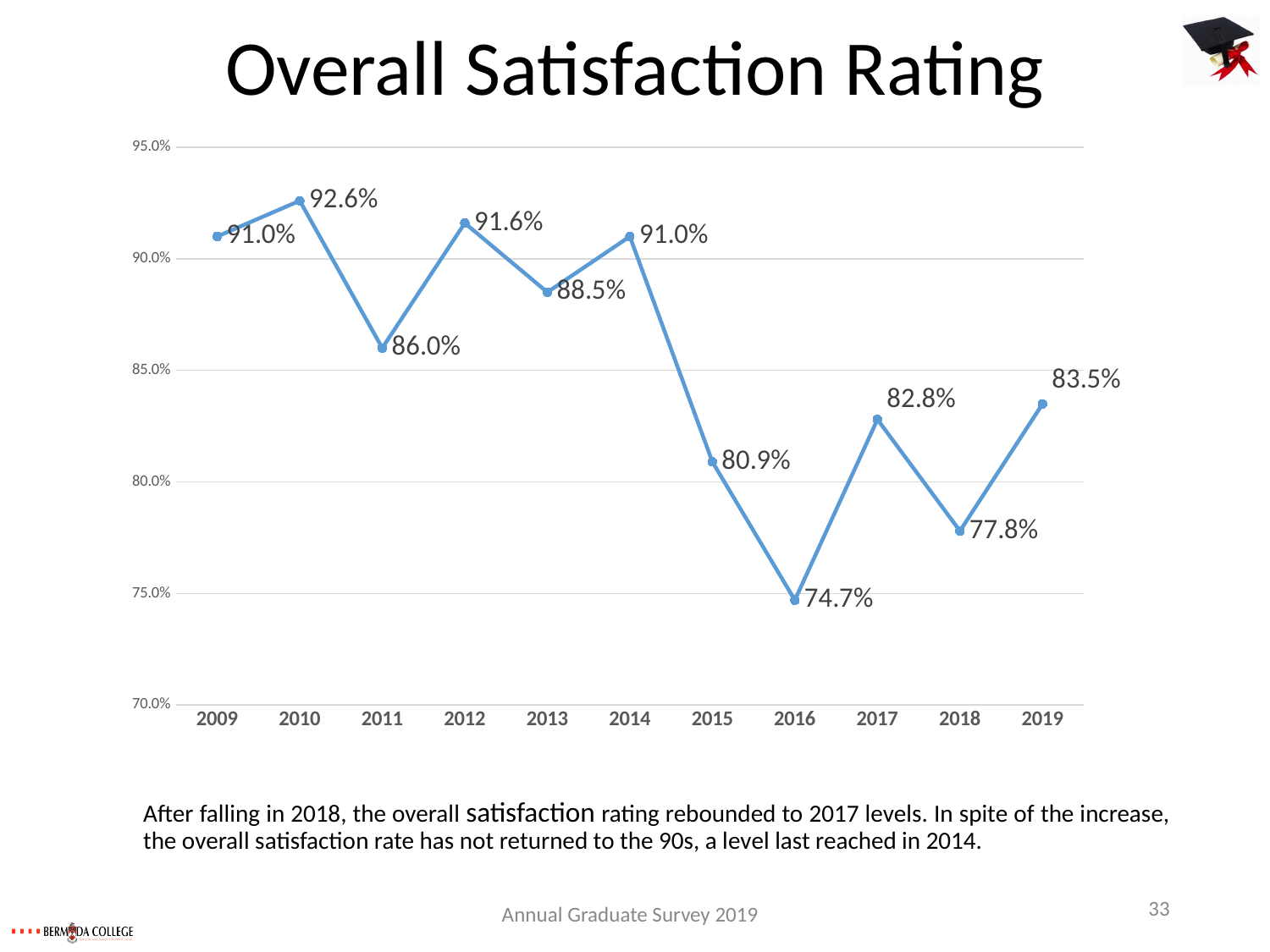
What is the overall satisfaction rating for 2010? 92.6% Does the satisfaction rating rise or fall from 2014 to 2016? fall Which year has a higher satisfaction rating, 2013 or 2015? 2013 How many years are plotted on the chart? 11 What is the overall satisfaction rating for 2019? 83.5% Which year has the lowest overall satisfaction rating? 2016 What kind of chart is shown on the slide? line chart What is the title of the chart? Overall Satisfaction Rating Which year has the highest overall satisfaction rating? 2010 Is the satisfaction rating for 2017 greater or less than 85.0%? less What is the difference between the 2019 and 2018 satisfaction ratings? 5.7% What is the overall satisfaction rating for 2016? 74.7%